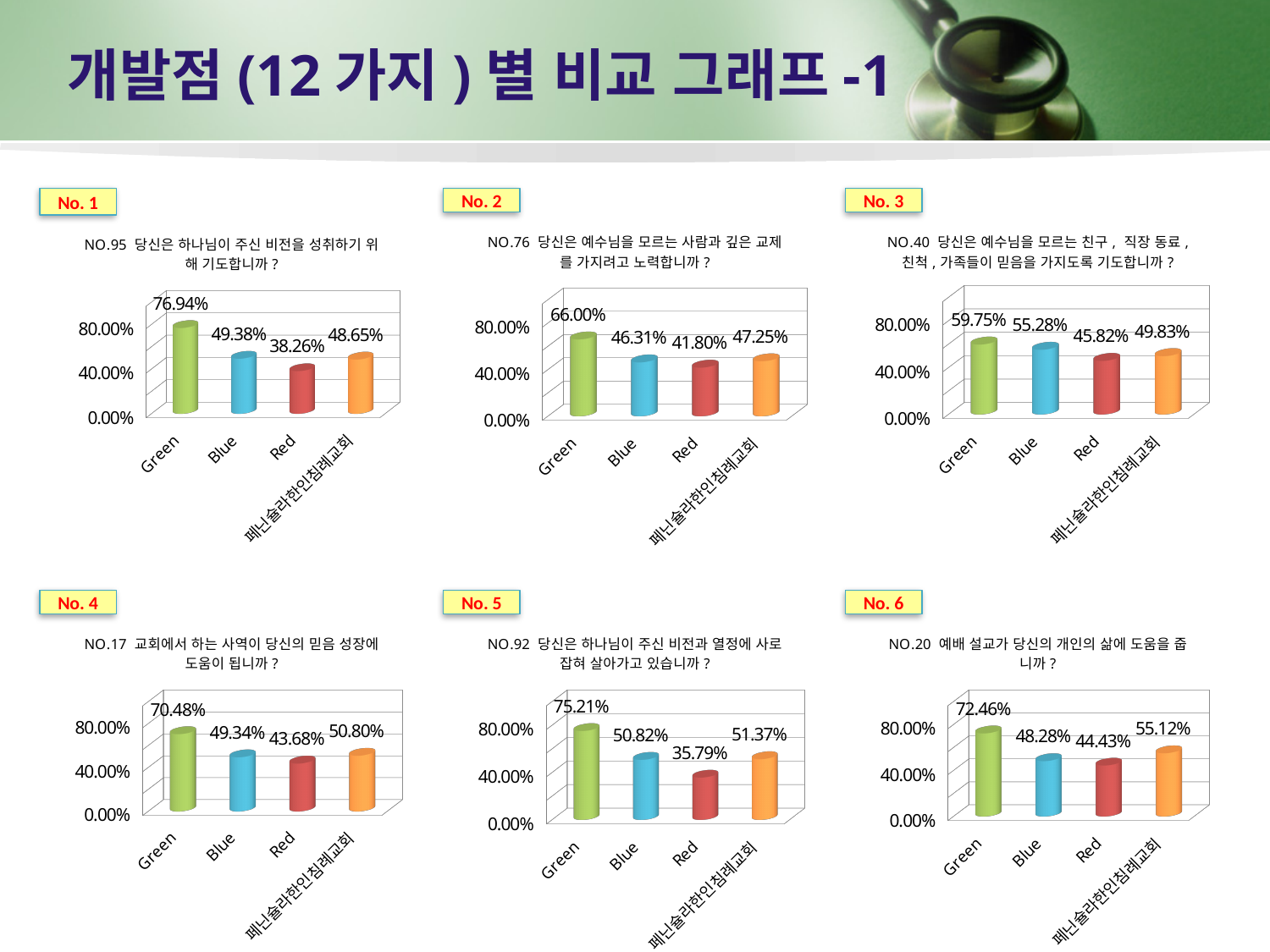
In the No. 5 chart, what is the difference between the Green value and the Red value? 39.42% What kind of chart is the No. 3 chart? bar chart In the No. 4 chart, what is the difference between the Blue value and the Red value? 5.66% In the No. 1 chart, what is the value for Green? 76.94% In the No. 6 chart, what is the value for 페닌슐라한인침례교회? 55.12% How many categories are shown in the No. 2 chart? 4 How many charts are shown on the slide? 6 In the No. 2 chart, what is the value for Red? 41.80% In the No. 6 chart, which is larger, the value for Blue or the value for 페닌슐라한인침례교회? 페닌슐라한인침례교회 In the No. 1 chart, is the value for Red greater or less than 40.00%? less In the No. 3 chart, which category has the lowest value? Red In the No. 4 chart, which category has the highest value? Green